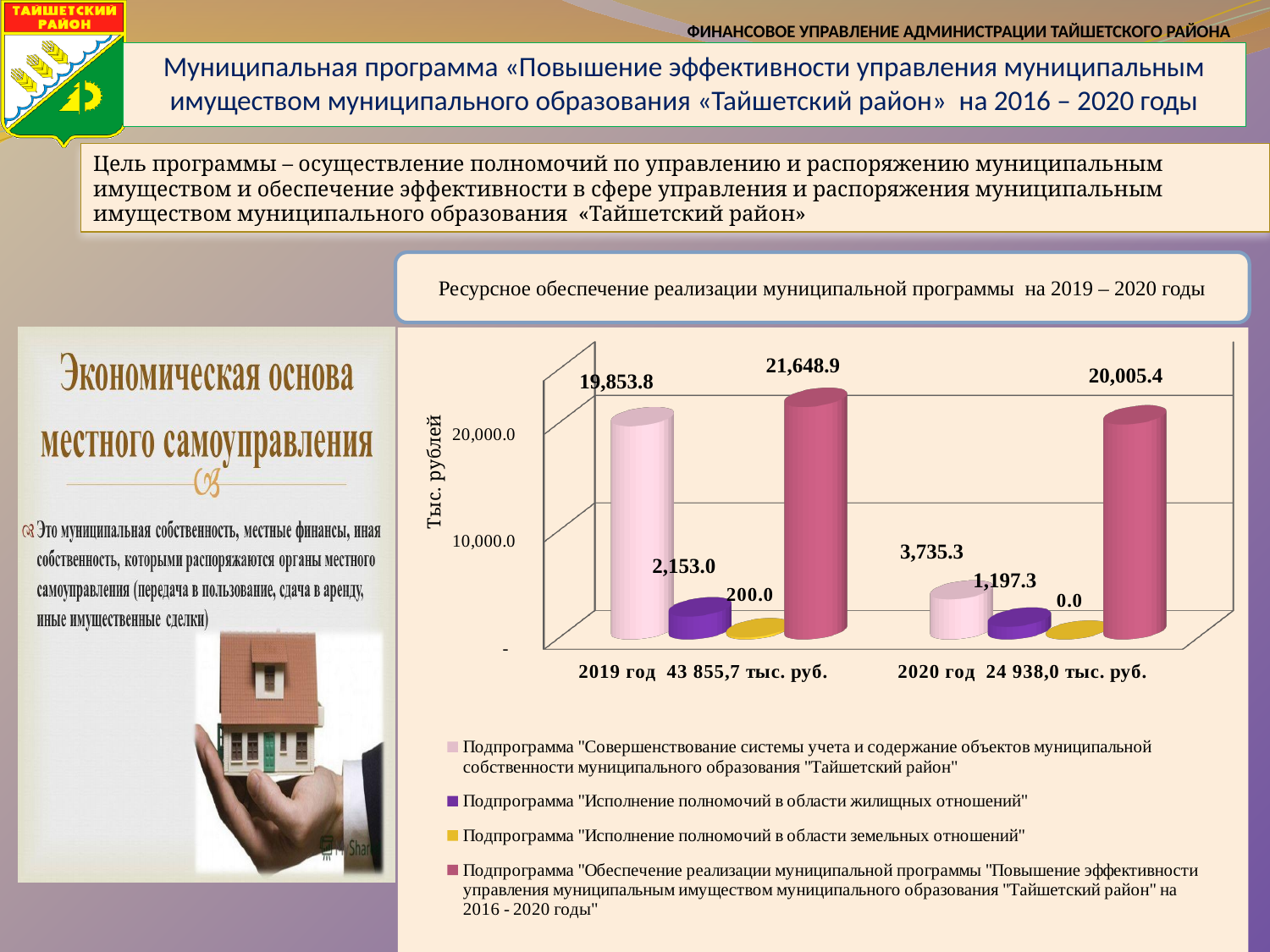
What is the difference between the 2019 and 2020 values for the subprogram "Совершенствование системы учета и содержание объектов муниципальной собственности"? 16,118.5 Which subprogram has the highest value in 2019? Подпрограмма "Обеспечение реализации муниципальной программы "Повышение эффективности управления муниципальным имуществом муниципального образования "Тайшетский район" на 2016 - 2020 годы" Which subprogram has the lowest value in 2020? Подпрограмма "Исполнение полномочий в области земельных отношений" What is the value for the subprogram "Совершенствование системы учета и содержание объектов муниципальной собственности" in 2019? 19,853.8 What unit is shown on the vertical axis of the chart? Тыс. рублей What is the value for the subprogram "Обеспечение реализации муниципальной программы" in 2020? 20,005.4 Which is larger: the 2019 value for the subprogram "Исполнение полномочий в области жилищных отношений" or its 2020 value? 2019 (2,153.0) What type of chart is shown on the slide? bar chart What is the value for the subprogram "Исполнение полномочий в области земельных отношений" in 2019? 200.0 How many categories (years) are shown on the x axis of the chart? 2 What is the value for the subprogram "Исполнение полномочий в области жилищных отношений" in 2020? 1,197.3 How many series does the chart legend list? 4